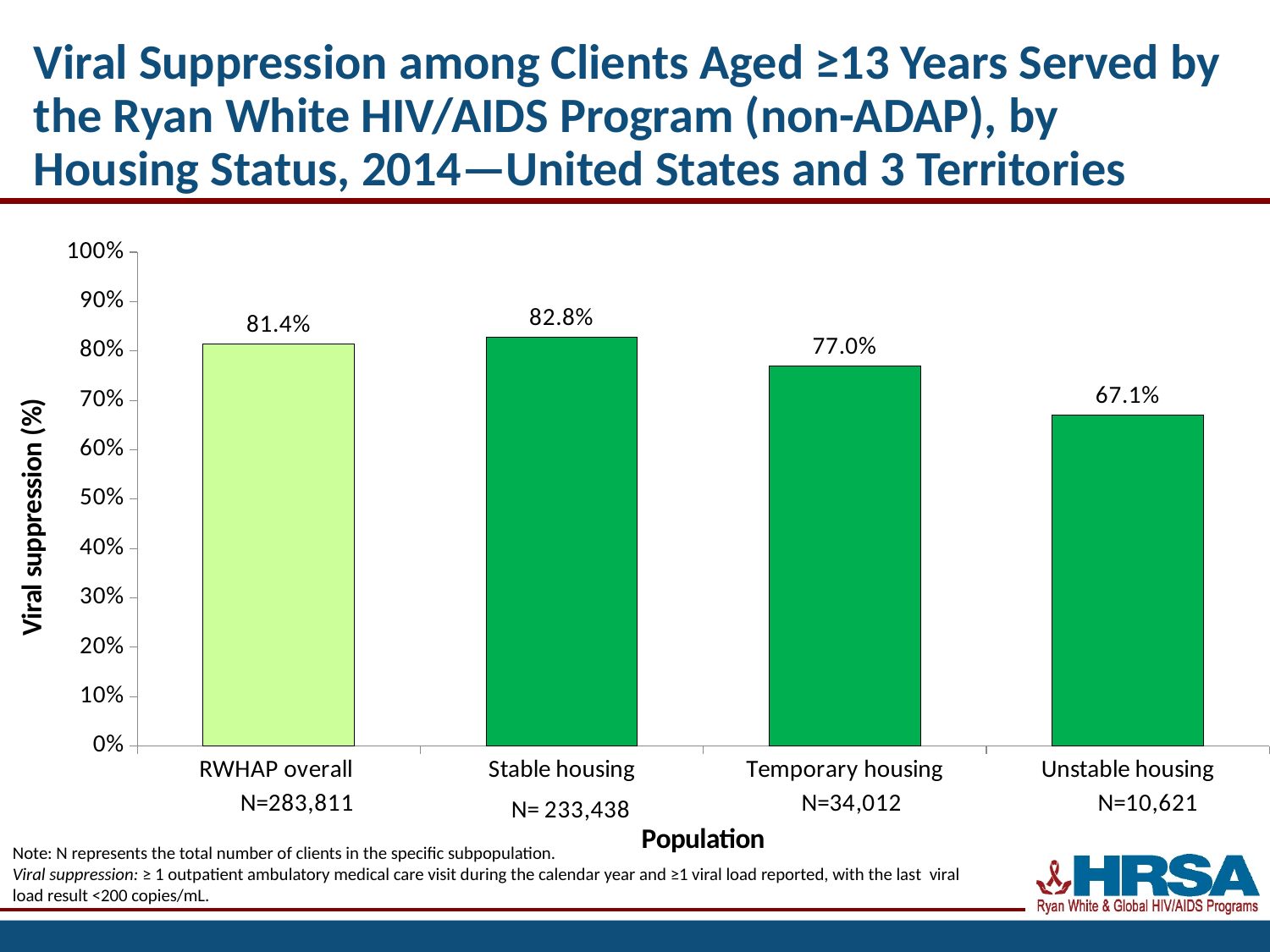
How many population categories are shown on the x axis? 4 Which population has the lowest viral suppression percentage? Unstable housing Is the value for Temporary housing greater or less than 70%? greater What is the difference in viral suppression between Stable housing and Unstable housing? 15.7 percentage points What is the N (number of clients) shown for Temporary housing? N=34,012 What is the viral suppression percentage for Unstable housing? 67.1% Which population has the highest viral suppression percentage? Stable housing What is the viral suppression percentage for RWHAP overall? 81.4% What kind of chart is shown on the slide? Bar chart Which has a higher viral suppression percentage, Temporary housing or Unstable housing? Temporary housing What is the label of the y axis? Viral suppression (%) What is the viral suppression percentage for Stable housing? 82.8%